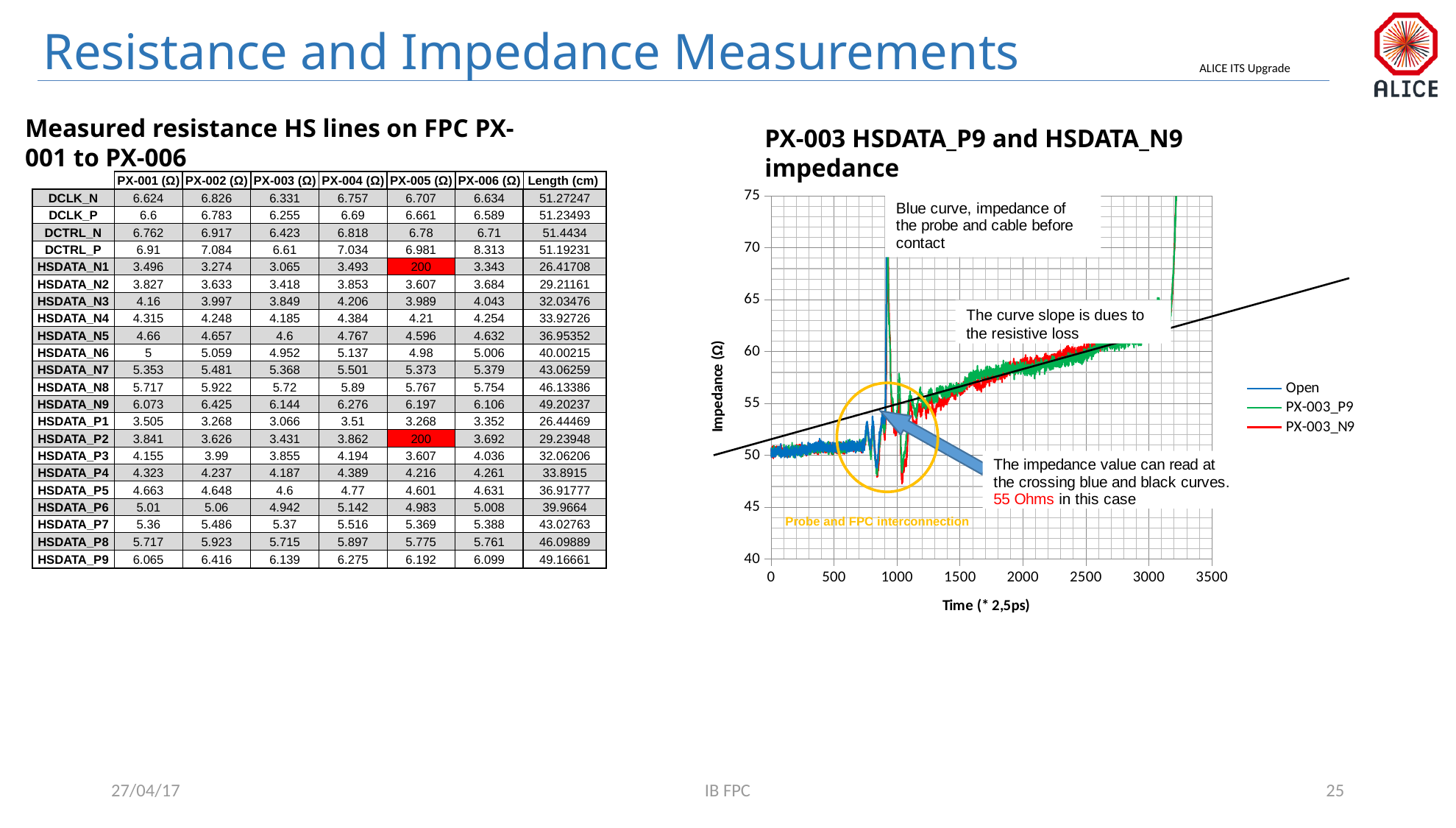
In the impedance chart, is the value of the PX-003_P9 curve at time 2000 greater or less than 65? less In the impedance chart, is the value of the PX-003_N9 curve at time 2500 greater or less than 55? greater In the impedance chart, what is the highest value shown on the Impedance (Ω) axis? 75 In the impedance chart, does the PX-003_P9 curve rise or fall between time 1500 and time 2500? rise In the impedance chart, what is the largest tick value shown on the Time axis? 3500 What is the title of the chart on the right side of the slide? PX-003 HSDATA_P9 and HSDATA_N9 impedance According to the annotation on the impedance chart, what impedance value is read at the crossing of the blue and black curves? 55 Ohms What kind of chart is shown on the right side of the slide? line chart In the impedance chart, is the value of the Open (blue) curve at time 500 greater or less than 55? less How many series does the legend of the impedance chart list? 3